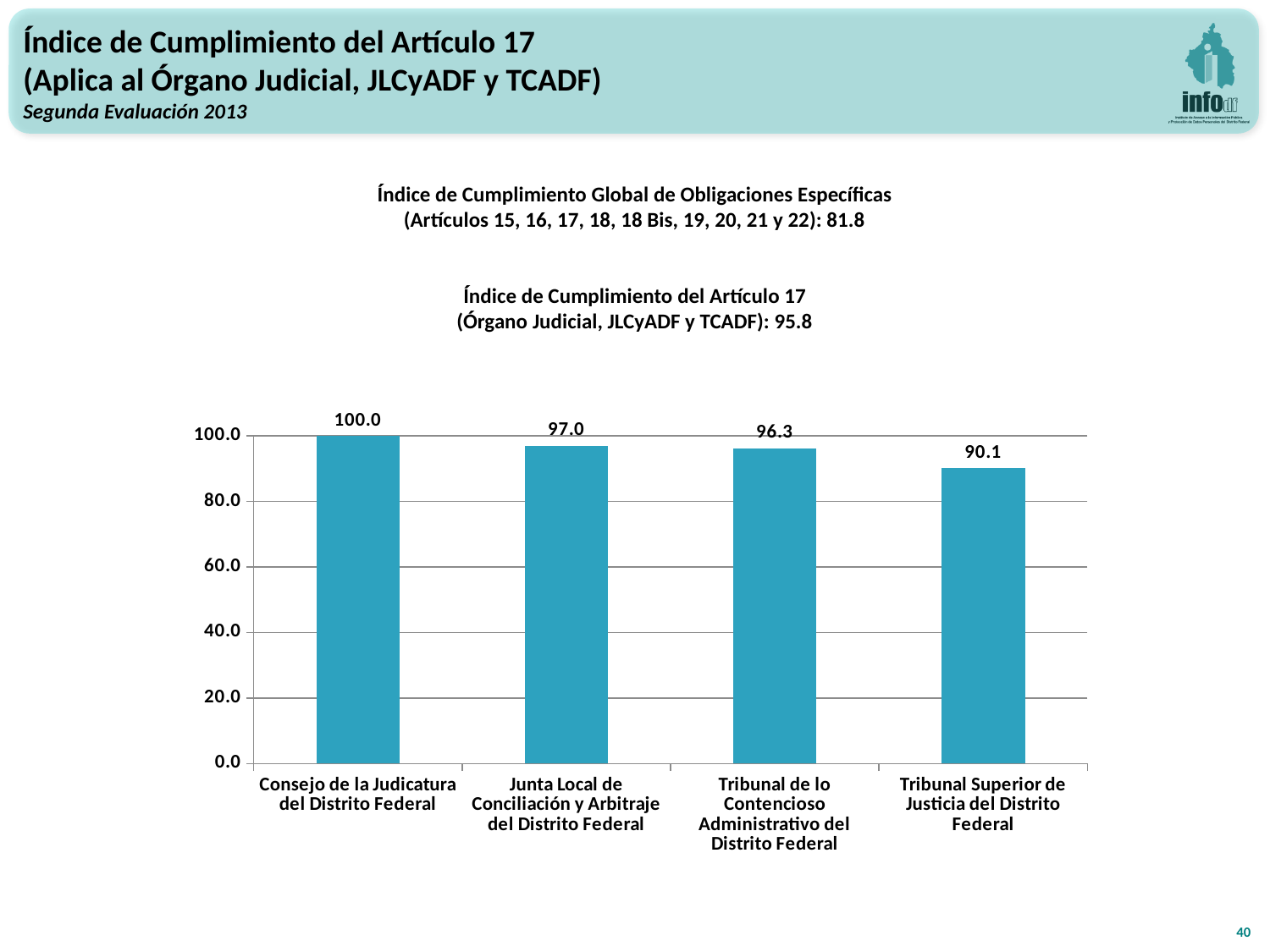
What kind of chart is shown on the slide? Bar chart Which category has the highest value? Consejo de la Judicatura del Distrito Federal Do the values rise or fall from left to right across the categories? Fall What is the value for Junta Local de Conciliación y Arbitraje del Distrito Federal? 97.0 What is the value for Consejo de la Judicatura del Distrito Federal? 100.0 Which category has the lowest value? Tribunal Superior de Justicia del Distrito Federal How many categories are shown in the chart? 4 What is the value for Tribunal de lo Contencioso Administrativo del Distrito Federal? 96.3 What is the difference between the values for Consejo de la Judicatura del Distrito Federal and Tribunal Superior de Justicia del Distrito Federal? 9.9 What is the value for Tribunal Superior de Justicia del Distrito Federal? 90.1 Which is larger, the value for Junta Local de Conciliación y Arbitraje del Distrito Federal or the value for Tribunal Superior de Justicia del Distrito Federal? Junta Local de Conciliación y Arbitraje del Distrito Federal What is the difference between the values for Junta Local de Conciliación y Arbitraje del Distrito Federal and Tribunal de lo Contencioso Administrativo del Distrito Federal? 0.7